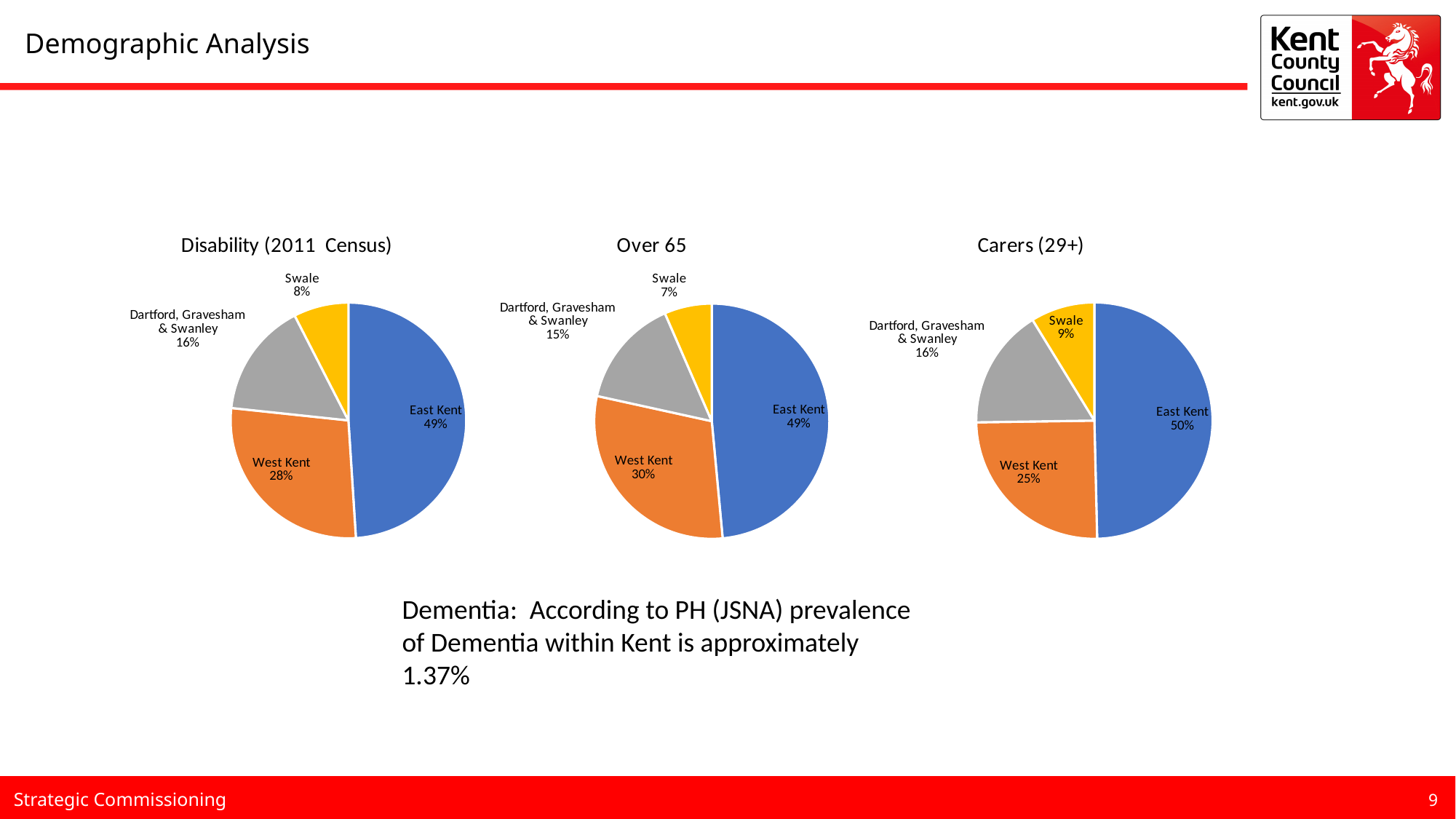
In the 'Carers (29+)' pie chart, what share does East Kent have? 50% How many pie charts are shown on the slide? 3 How many slices does the 'Carers (29+)' pie chart have? 4 In the 'Over 65' pie chart, what share does Swale have? 7% In the 'Over 65' pie chart, which is larger: the share for West Kent or the share for Dartford, Gravesham & Swanley? West Kent What type of chart is the 'Over 65' chart? Pie chart In the 'Disability (2011 Census)' pie chart, what share does West Kent have? 28% In the 'Over 65' pie chart, which area has the largest share? East Kent In the 'Carers (29+)' pie chart, which area has the smallest share? Swale In the 'Disability (2011 Census)' pie chart, what is the difference between the East Kent and West Kent shares? 21% What colour is the East Kent slice in the 'Disability (2011 Census)' pie chart? Blue